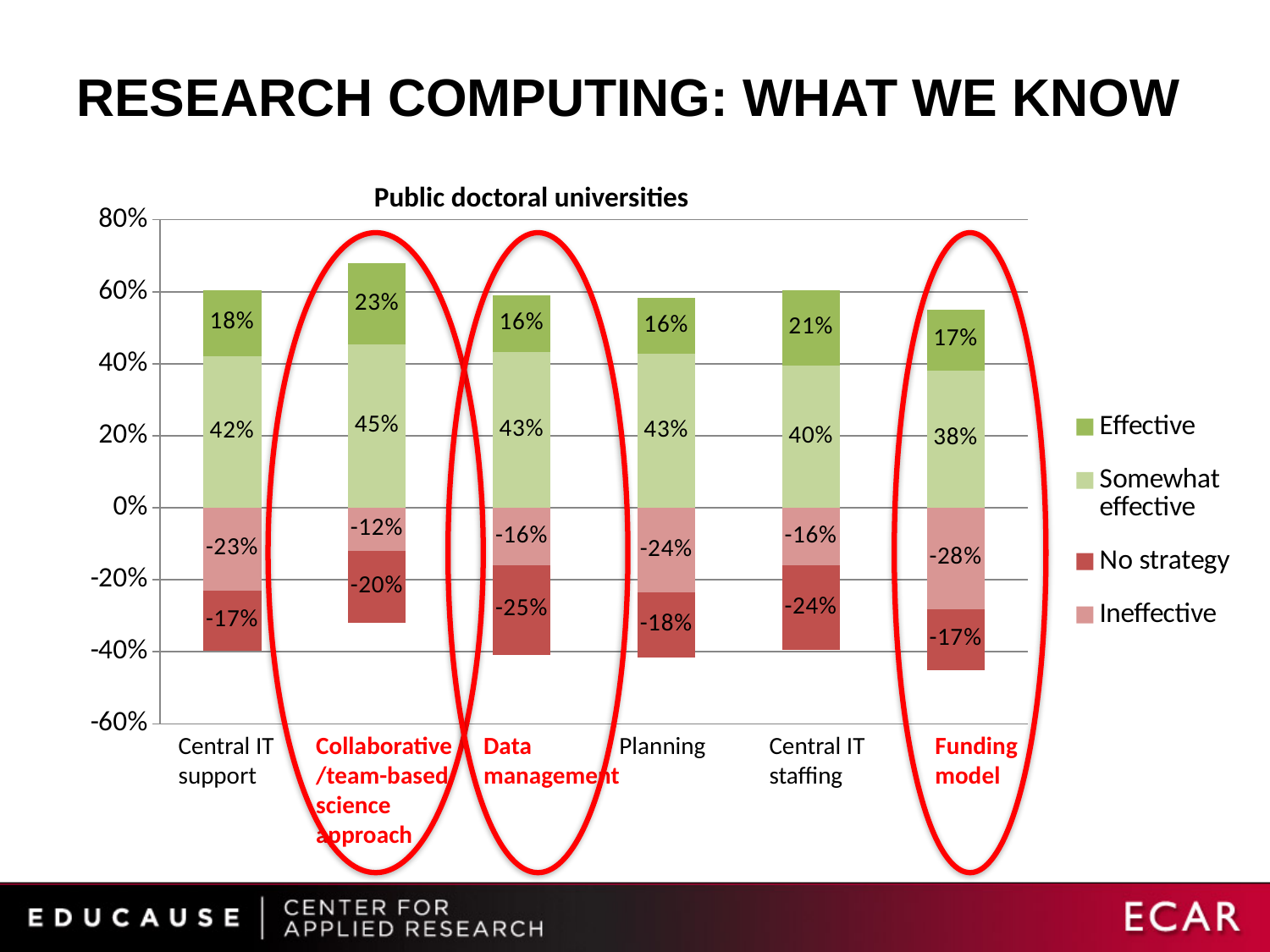
What is the Ineffective value for Funding model? -28% What is the difference between the Somewhat effective values for Collaborative/team-based science approach and Funding model? 7 percentage points How many series does the legend list? 4 Which has a larger Effective value, Central IT support or Central IT staffing? Central IT staffing How many categories are shown on the x axis? 6 What kind of chart is shown? Stacked bar chart What is the No strategy value for Data management? -25% What is the Effective value for Collaborative/team-based science approach? 23% What is the combined total of the Effective and Somewhat effective segments for Central IT support? 60% Which category has the highest Effective value? Collaborative/team-based science approach Which category has the lowest Somewhat effective value? Funding model What is the Somewhat effective value for Funding model? 38%